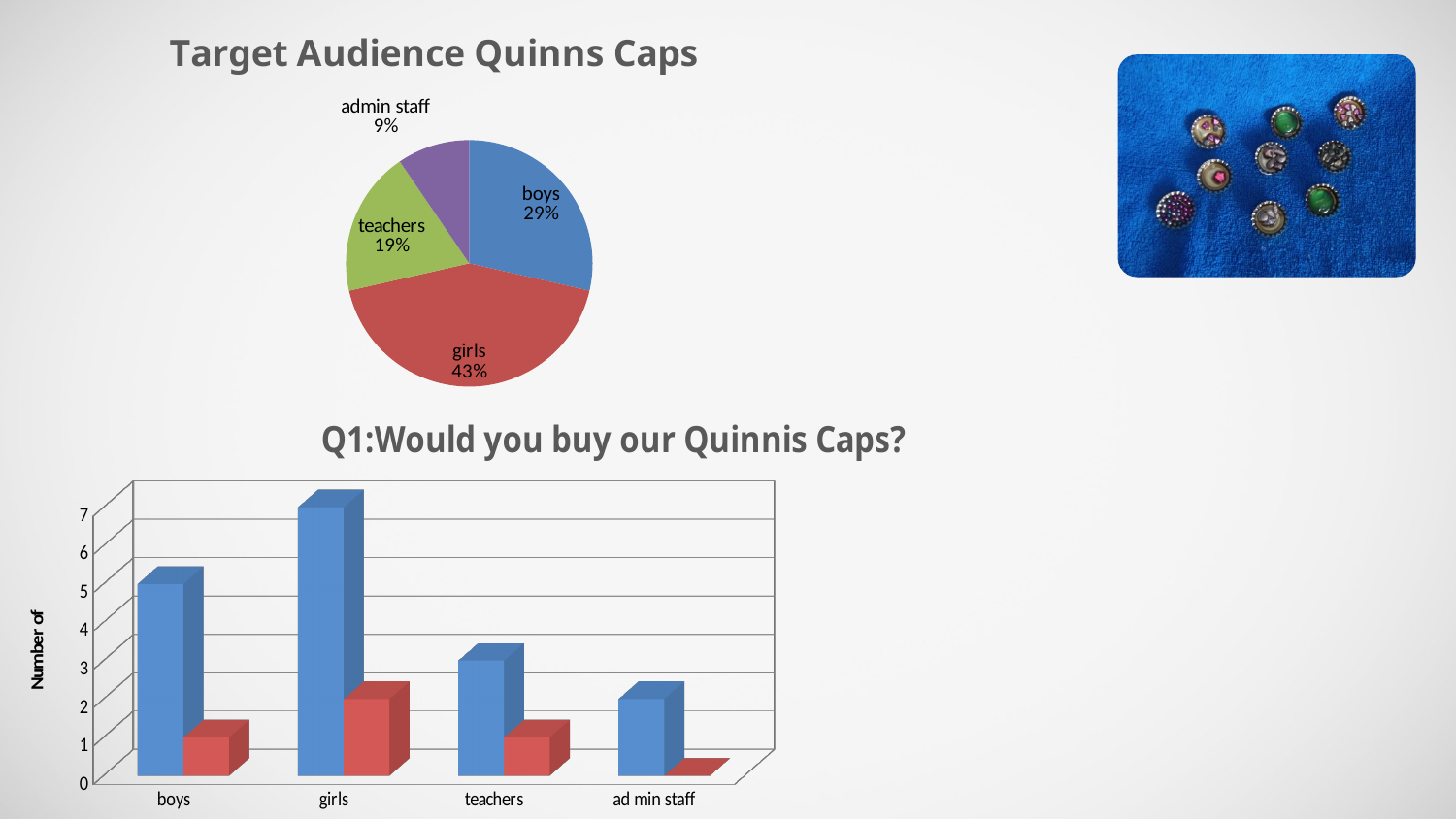
In the bar chart under 'Q1: Would you buy our Quinnis Caps?', is the blue bar for teachers greater or less than 4? less In the pie chart titled 'Target Audience Quinns Caps', what percentage is shown for admin staff? 9% In the bar chart under 'Q1: Would you buy our Quinnis Caps?', is the blue bar for girls greater or less than 6? greater In the pie chart titled 'Target Audience Quinns Caps', which group has the largest share? girls In the pie chart titled 'Target Audience Quinns Caps', what percentage is shown for teachers? 19% In the pie chart titled 'Target Audience Quinns Caps', which group has the smallest share? admin staff In the pie chart titled 'Target Audience Quinns Caps', how many slices are there? 4 In the bar chart under 'Q1: Would you buy our Quinnis Caps?', which category has the tallest blue bar? girls What kind of chart is the one at the bottom of the slide under 'Q1: Would you buy our Quinnis Caps?'? bar chart In the pie chart titled 'Target Audience Quinns Caps', what is the difference in percentage points between girls and boys? 14 In the pie chart titled 'Target Audience Quinns Caps', what percentage is shown for girls? 43% What kind of chart is the one at the top of the slide titled 'Target Audience Quinns Caps'? pie chart